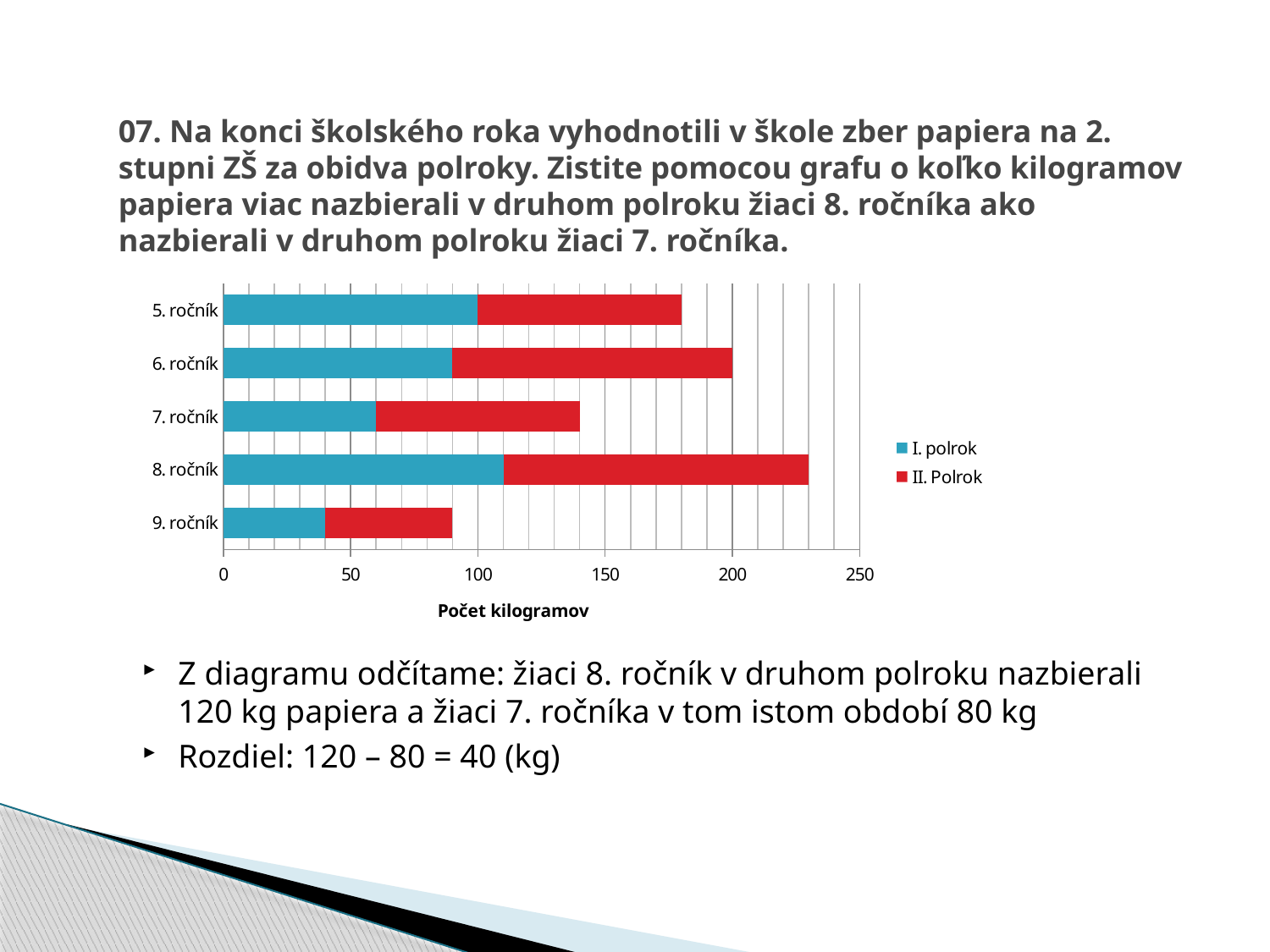
How many categories (ročníky) are shown on the chart? 5 What is the title of the horizontal axis? Počet kilogramov Is the total for 8. ročník greater or less than 200? greater How many series does the chart legend list? 2 Which has the larger total, 5. ročník or 6. ročník? 6. ročník What is the total of the stacked bar for 6. ročník? 200 Which category has the longest total bar? 8. ročník What kind of chart is shown on the slide? bar chart Which category has the shortest total bar? 9. ročník What is the I. polrok value for 5. ročník? 100 According to the slide, how many more kilograms did 8. ročník collect than 7. ročník in the second half-year (II. polrok)? 40 (kg) Is the total for 9. ročník greater or less than 100? less